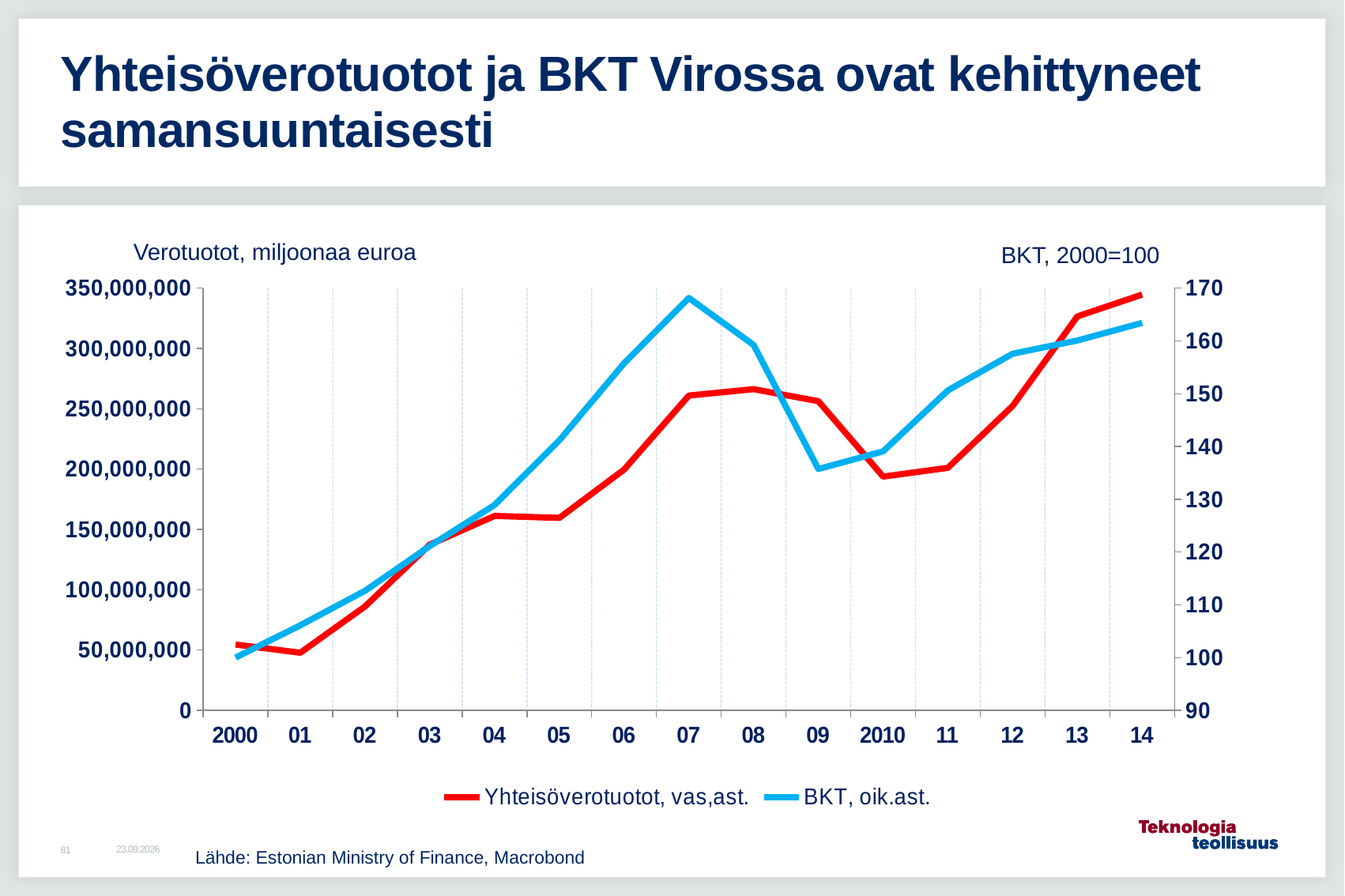
What kind of chart is shown on the slide? line chart Is the Yhteisöverotuotot value for 13 greater or less than 300,000,000? greater How many years are plotted along the x axis? 15 In which year is the Yhteisöverotuotot series at its highest? 14 In which year is the Yhteisöverotuotot series at its lowest? 01 Which year has the larger Yhteisöverotuotot value, 2010 or 13? 13 What are the two series named in the legend? Yhteisöverotuotot, vas,ast. and BKT, oik.ast. What is the label of the right-hand axis? BKT, 2000=100 In which year is the BKT series at its highest? 07 How many series does the legend list? 2 Does the BKT series rise or fall between 07 and 09? fall Is the BKT value for 09 greater or less than 140? less